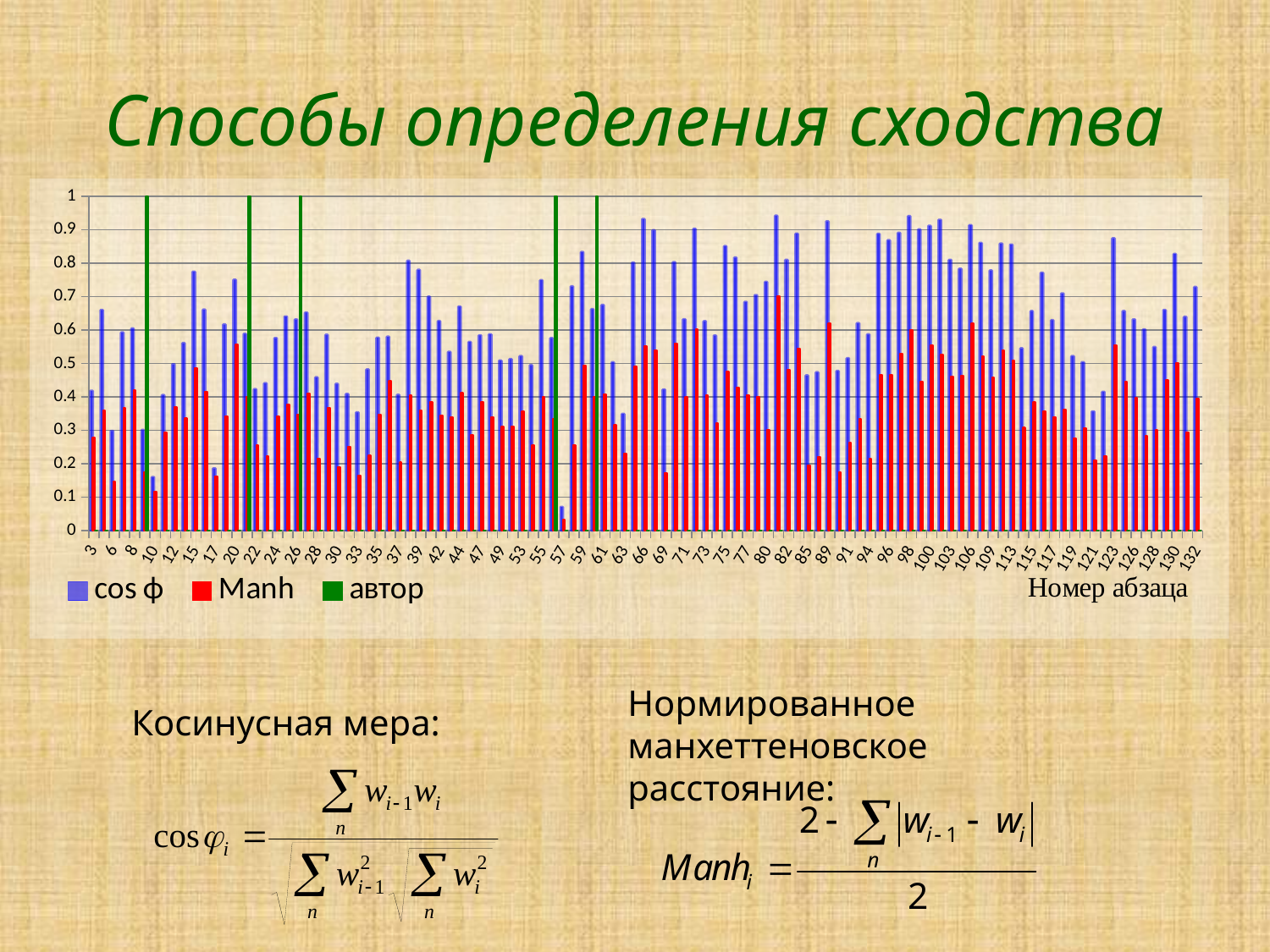
What are the three series named in the chart legend? cos ф, Manh, автор What is the highest value marked on the y axis of the chart? 1 Is the cos ф value for paragraph 80 greater or less than 0.8? less How many series does the chart legend list? 3 What kind of chart is shown on the slide? bar chart Is the Manh value for paragraph 10 greater or less than 0.2? less What value do the green автор bars reach on the y axis? 1 Is the cos ф value for paragraph 57 greater or less than 0.2? less What is the title of the x axis of the chart? Номер абзаца For paragraph 98, which series has the larger value, cos ф or Manh? cos ф